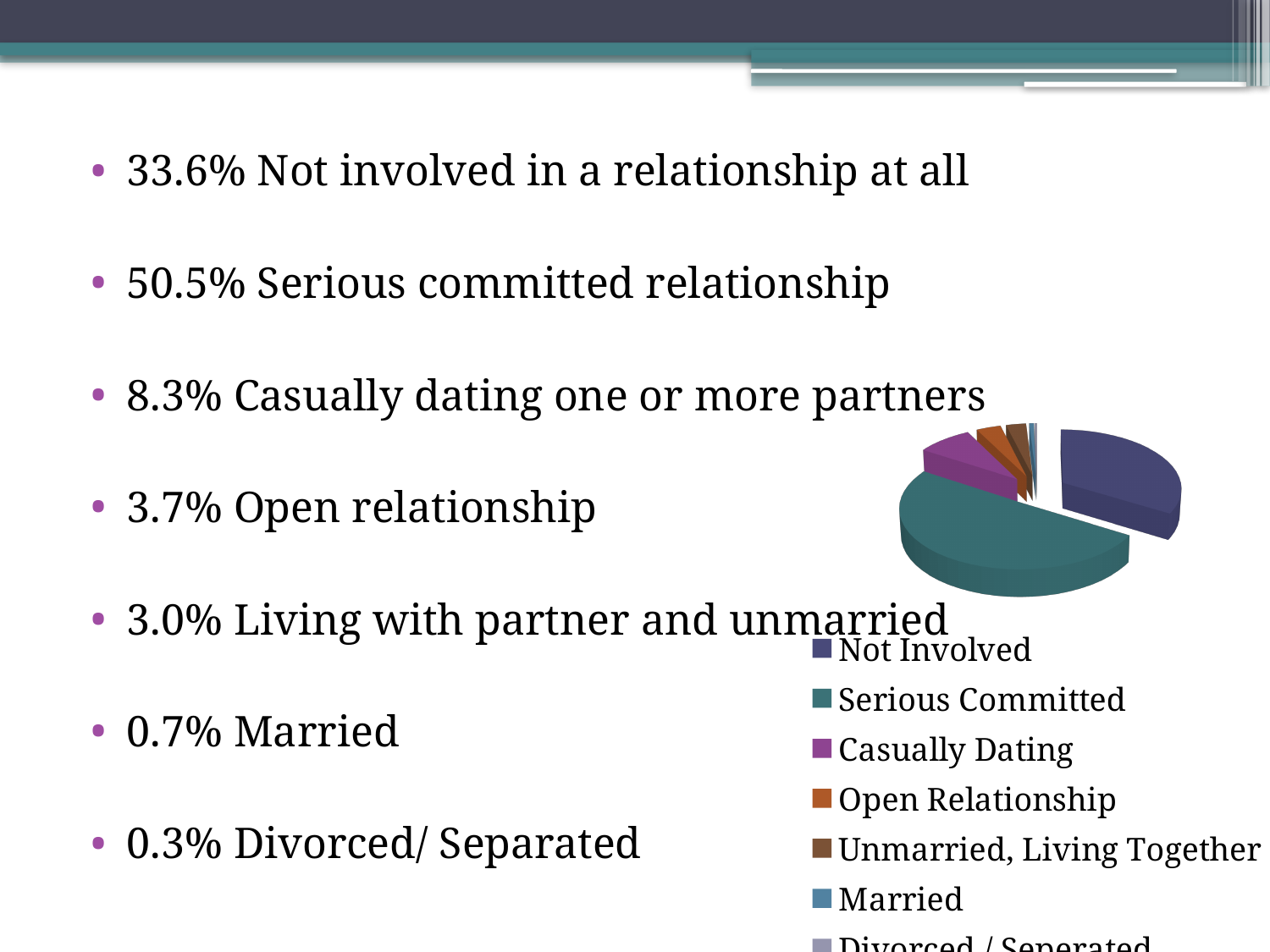
What type of chart is shown on the slide? Pie chart How many categories does the pie chart's legend list? 7 What share of the pie does the Serious Committed slice represent, according to the slide? 50.5% What share of the pie does the Casually Dating slice represent, according to the slide? 8.3% What share of the pie does the Not Involved slice represent, according to the slide? 33.6% Which slice is pulled out (exploded) from the rest of the pie chart? Not Involved Which slice is larger in the pie chart, Not Involved or Casually Dating? Not Involved Which category has the smallest slice in the pie chart? Divorced / Separated Which category has the largest slice in the pie chart? Serious Committed What colour is the Serious Committed slice in the pie chart? Teal Which slice is larger in the pie chart, Serious Committed or Not Involved? Serious Committed What is the difference in percentage points between the Serious Committed and Not Involved shares shown on the slide? 16.9%